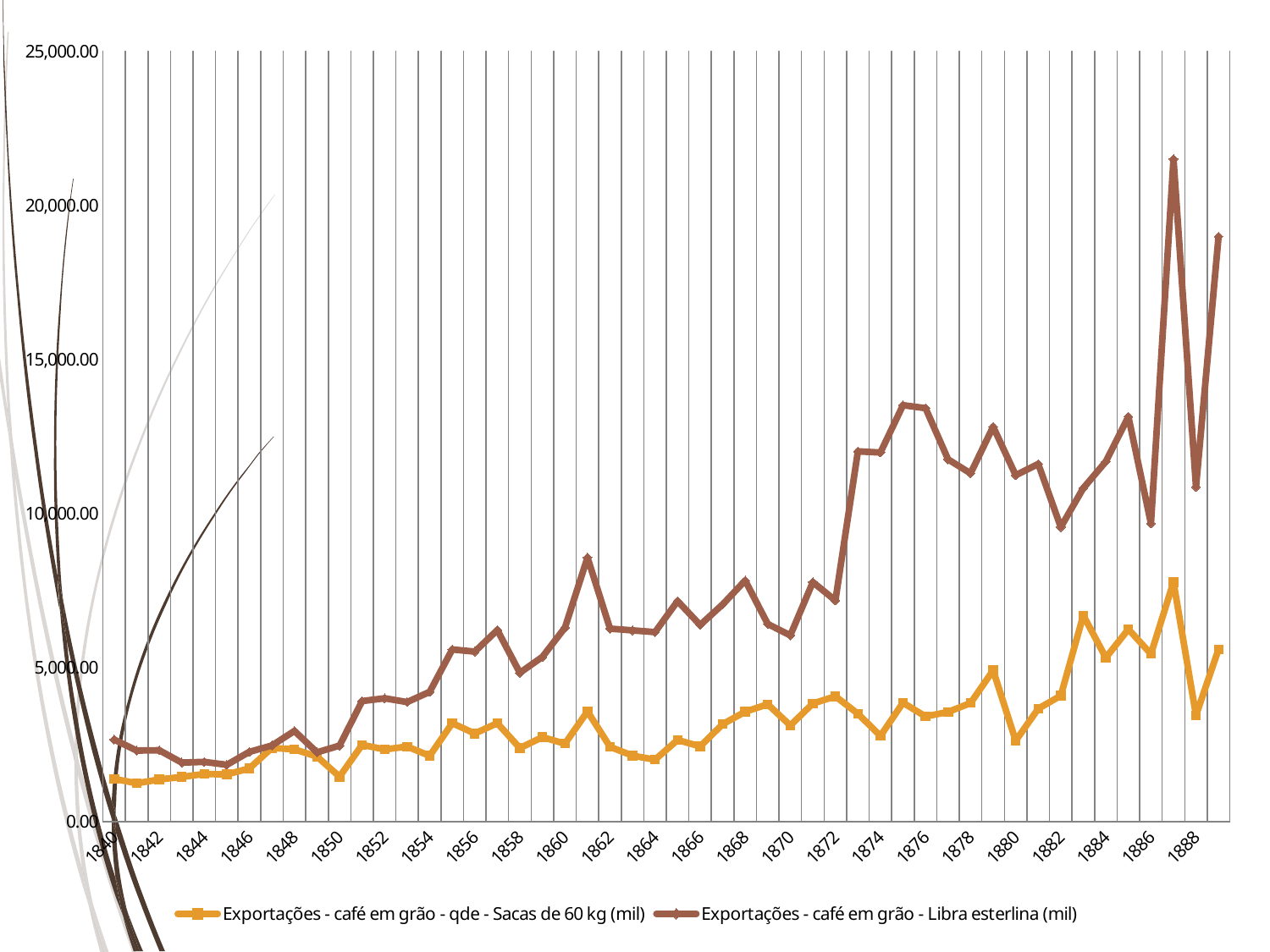
Which series is drawn in brown? Exportações - café em grão - Libra esterlina (mil) In 1887, which series has the higher value: 'Sacas de 60 kg (mil)' or 'Libra esterlina (mil)'? Libra esterlina (mil) Is the value of the 'Libra esterlina (mil)' series in 1875 greater or less than 10,000.00? greater How many series does the legend list? 2 What is the highest value label on the vertical axis? 25,000.00 Is the value of the 'Libra esterlina (mil)' series in 1840 greater or less than 5,000.00? less Is the value of the 'Sacas de 60 kg (mil)' series in 1887 greater or less than 5,000.00? greater In which year does the 'Sacas de 60 kg (mil)' series reach its highest value? 1887 In which year does the 'Libra esterlina (mil)' series reach its highest value? 1887 Overall, do the values of the 'Libra esterlina (mil)' series rise or fall from 1840 to 1889? Rise What kind of chart is shown on the slide? Line chart